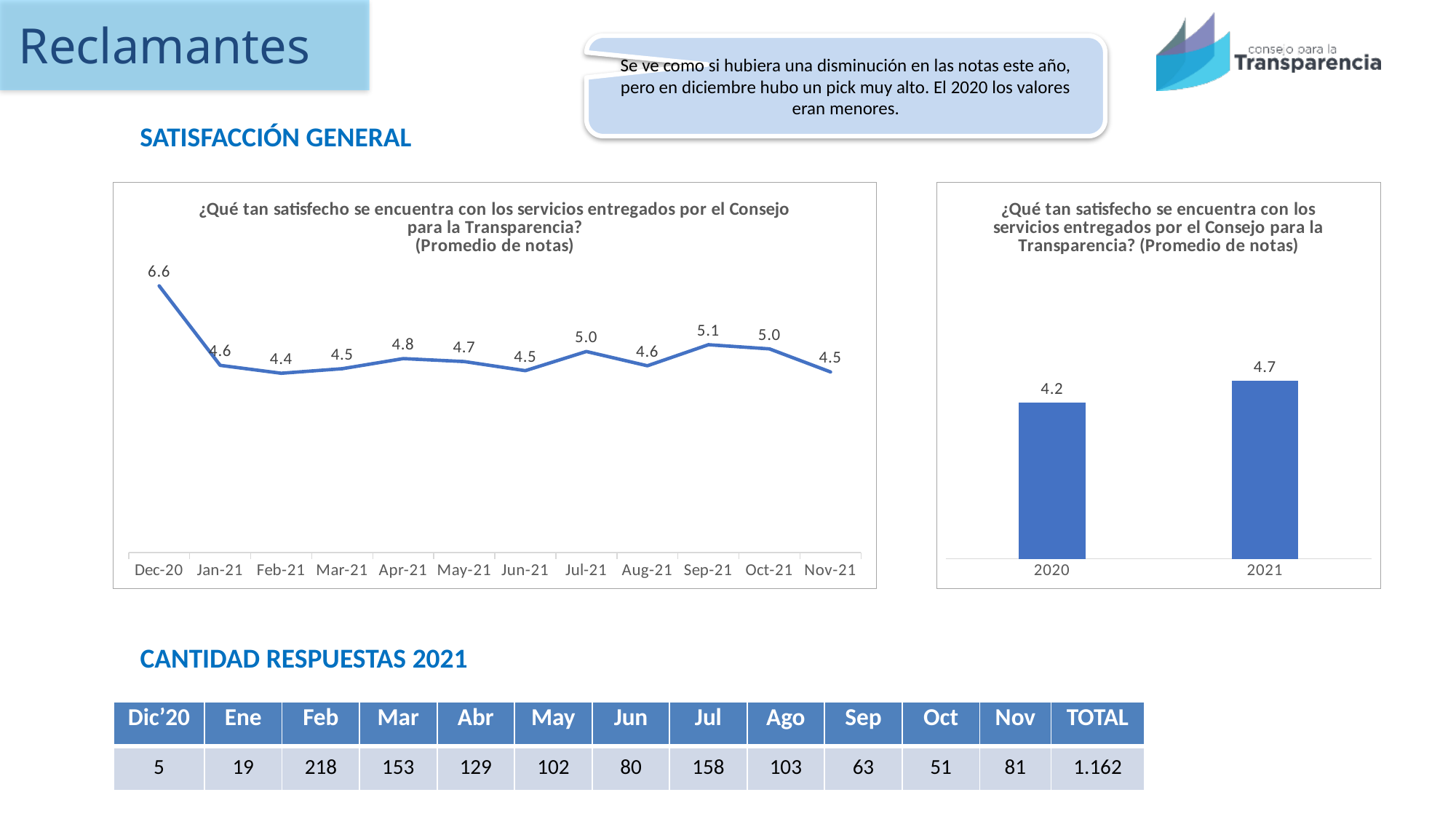
In the line chart on the left, what is the value for Sep-21? 5.1 What kind of chart is the chart on the left? Line chart What kind of chart is the chart on the right? Bar chart In the line chart on the left, which is larger, the value for Jul-21 or the value for Aug-21? Jul-21 How many months are plotted in the line chart on the left? 12 In the bar chart on the right, which year has the higher value? 2021 In the bar chart on the right, what is the difference between the values for 2021 and 2020? 0.5 In the line chart on the left, which month has the highest value? Dec-20 In the bar chart on the right, what is the value for 2021? 4.7 In the line chart on the left, which month has the lowest value? Feb-21 In the line chart on the left, what is the difference between the values for Dec-20 and Jan-21? 2.0 In the line chart on the left, what is the value for Dec-20? 6.6